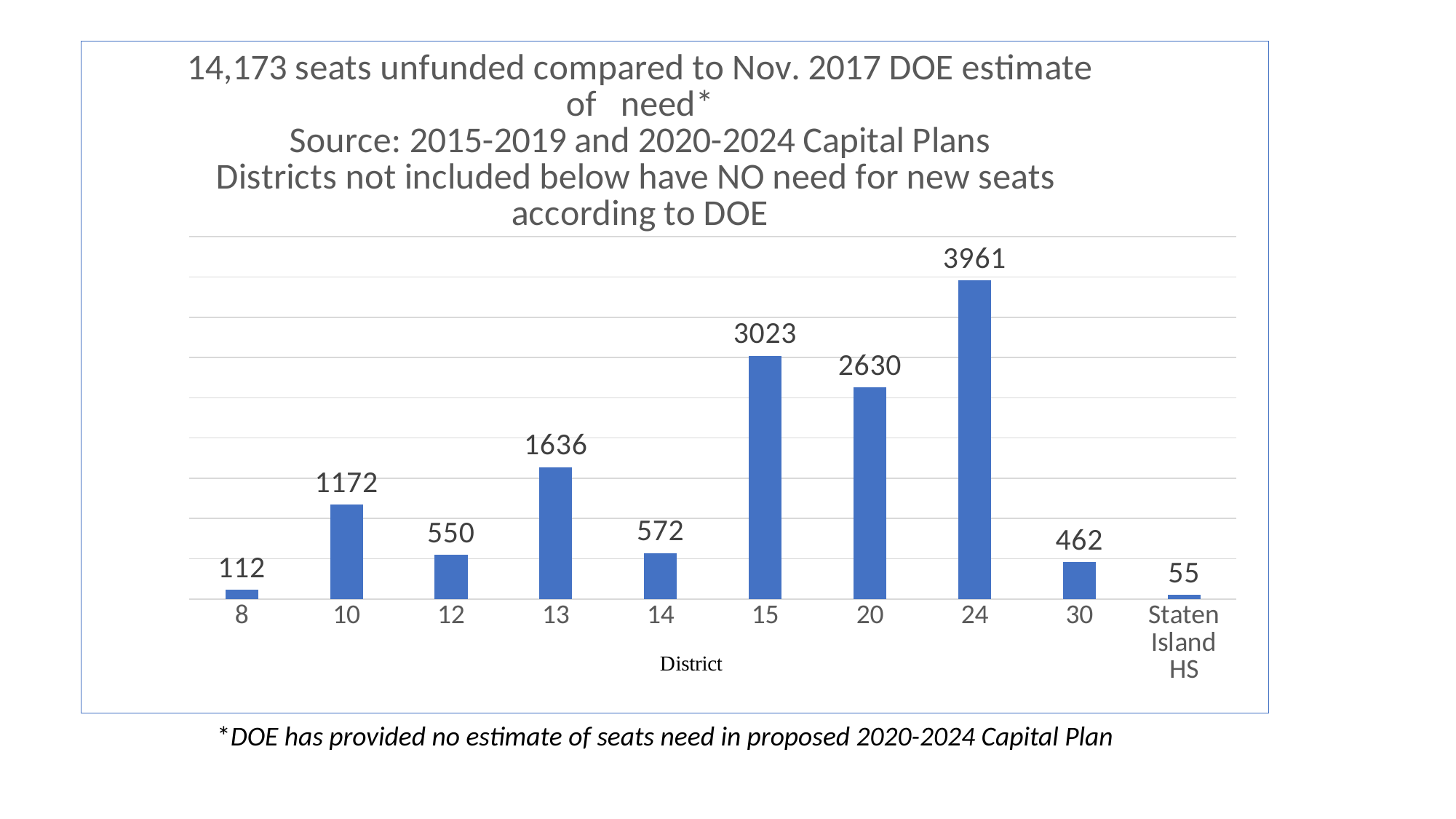
What is the x-axis title of the chart? District According to the chart title, how many seats are unfunded compared to the Nov. 2017 DOE estimate of need? 14,173 What is the value for District 24? 3961 Which is larger, the value for District 12 or District 14? District 14 What is the value for District 13? 1636 Which category has the lowest value? Staten Island HS What is the difference between the values for District 15 and District 20? 393 What is the value for Staten Island HS? 55 How many categories are shown on the x axis? 10 What kind of chart is shown on the slide? Bar chart Which district has the highest number of unfunded seats? 24 What is the difference between the values for District 10 and District 8? 1060